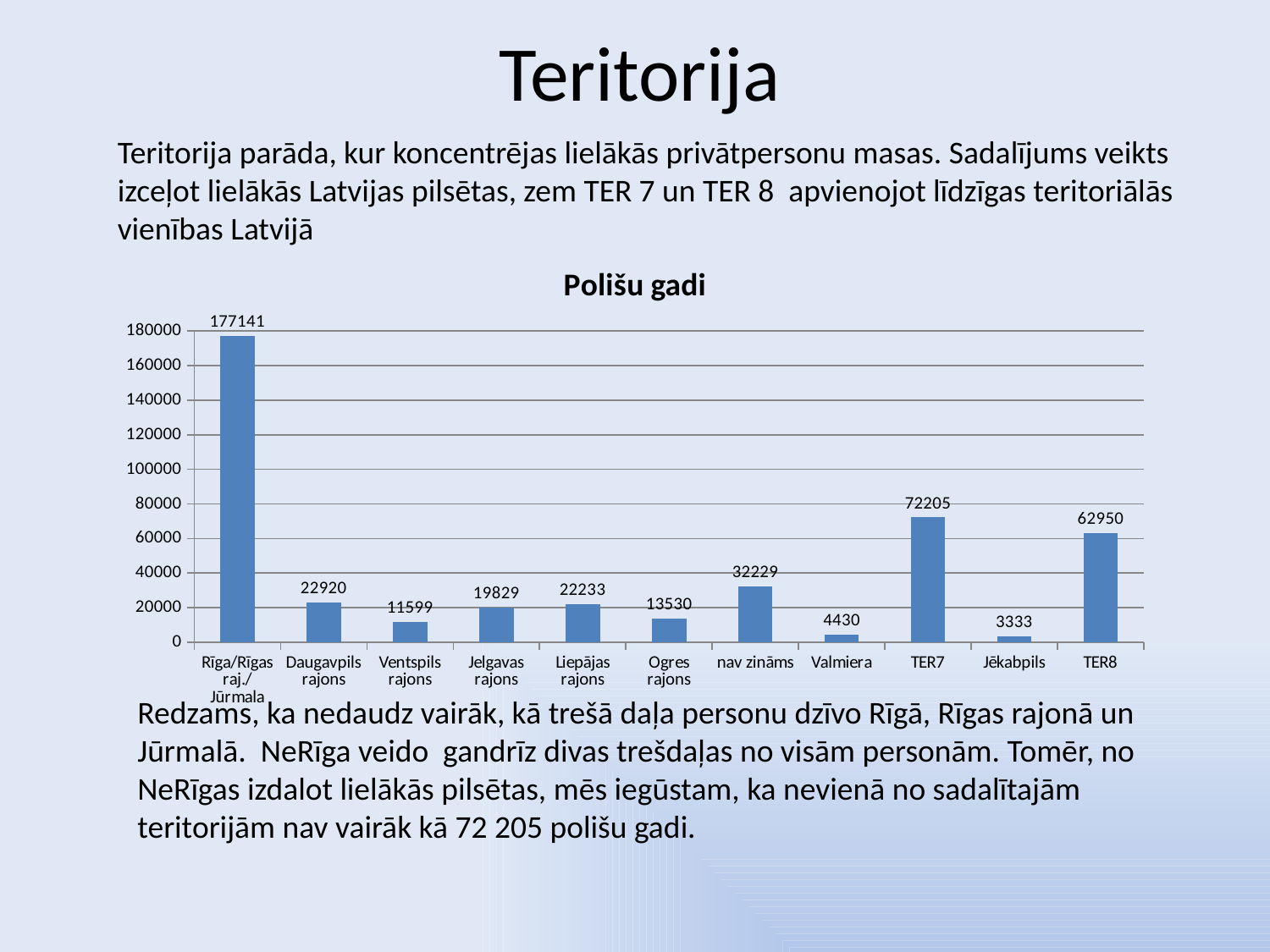
What is the title of the chart? Polišu gadi How many categories are shown on the x axis? 11 What is the value for TER7? 72205 Is the value for Ventspils rajons greater or less than 20000? less Which category has the highest value? Rīga/Rīgas raj./Jūrmala Which is larger, the value for Liepājas rajons or the value for Ogres rajons? Liepājas rajons What is the value for nav zināms? 32229 What is the difference between the values for TER7 and TER8? 9255 Which category has the lowest value? Jēkabpils What is the value for Daugavpils rajons? 22920 What is the difference between the values for Jelgavas rajons and Ventspils rajons? 8230 What kind of chart is shown on the slide? bar chart